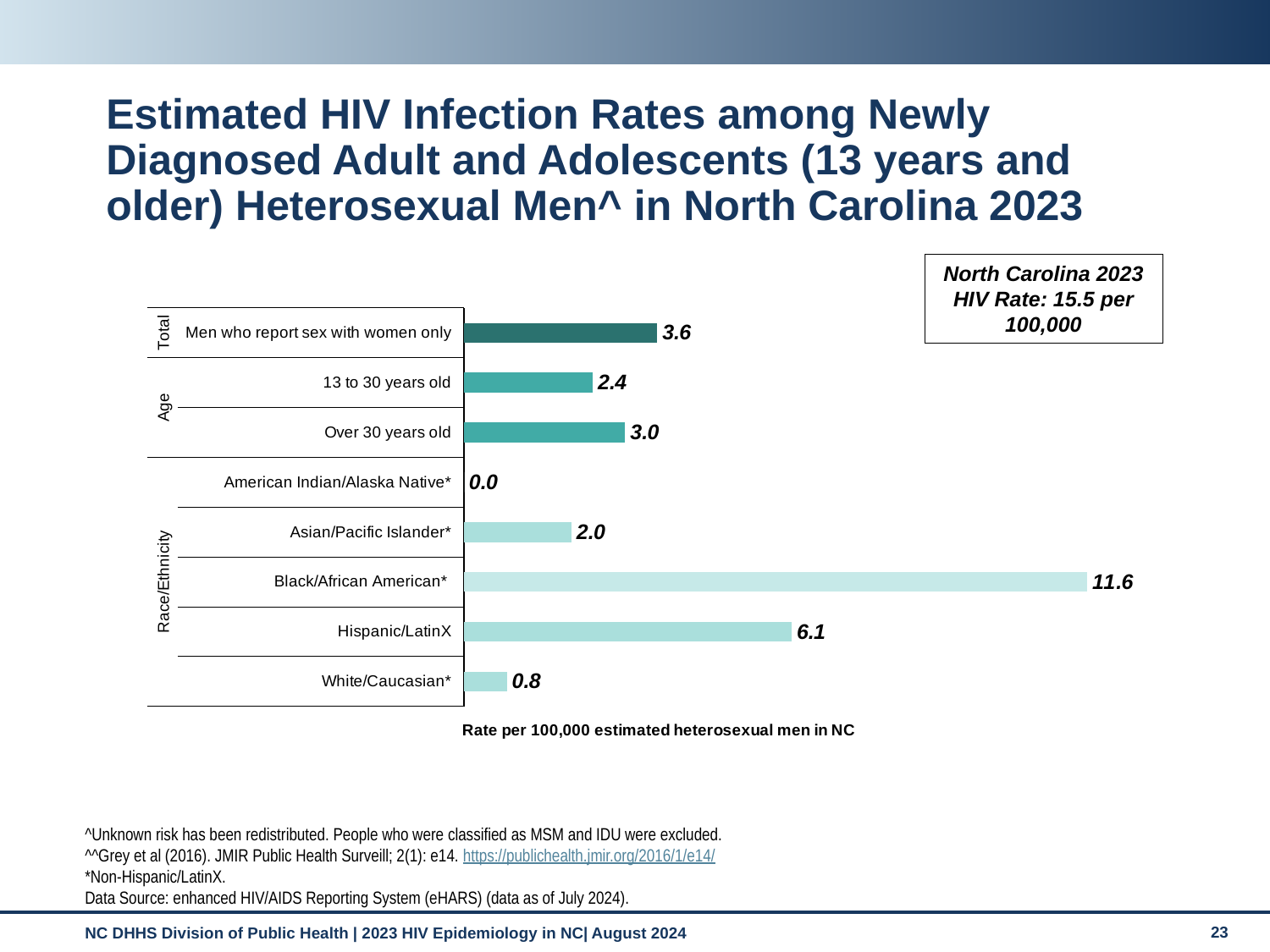
How many categories are plotted in the chart? 8 What is the rate for men who report sex with women only (Total)? 3.6 What is the rate for Black/African American* heterosexual men? 11.6 What is the rate for Hispanic/LatinX heterosexual men? 6.1 What is the overall North Carolina 2023 HIV rate shown in the box on the slide? 15.5 per 100,000 Which category has the highest rate? Black/African American* What kind of chart is shown on the slide? Bar chart What is the rate for the 13 to 30 years old group? 2.4 Which has a higher rate: 13 to 30 years old or Over 30 years old? Over 30 years old What is the difference between the rates for Black/African American* and Hispanic/LatinX? 5.5 Which category has the lowest rate? American Indian/Alaska Native* What is the difference between the rates for Over 30 years old and 13 to 30 years old? 0.6